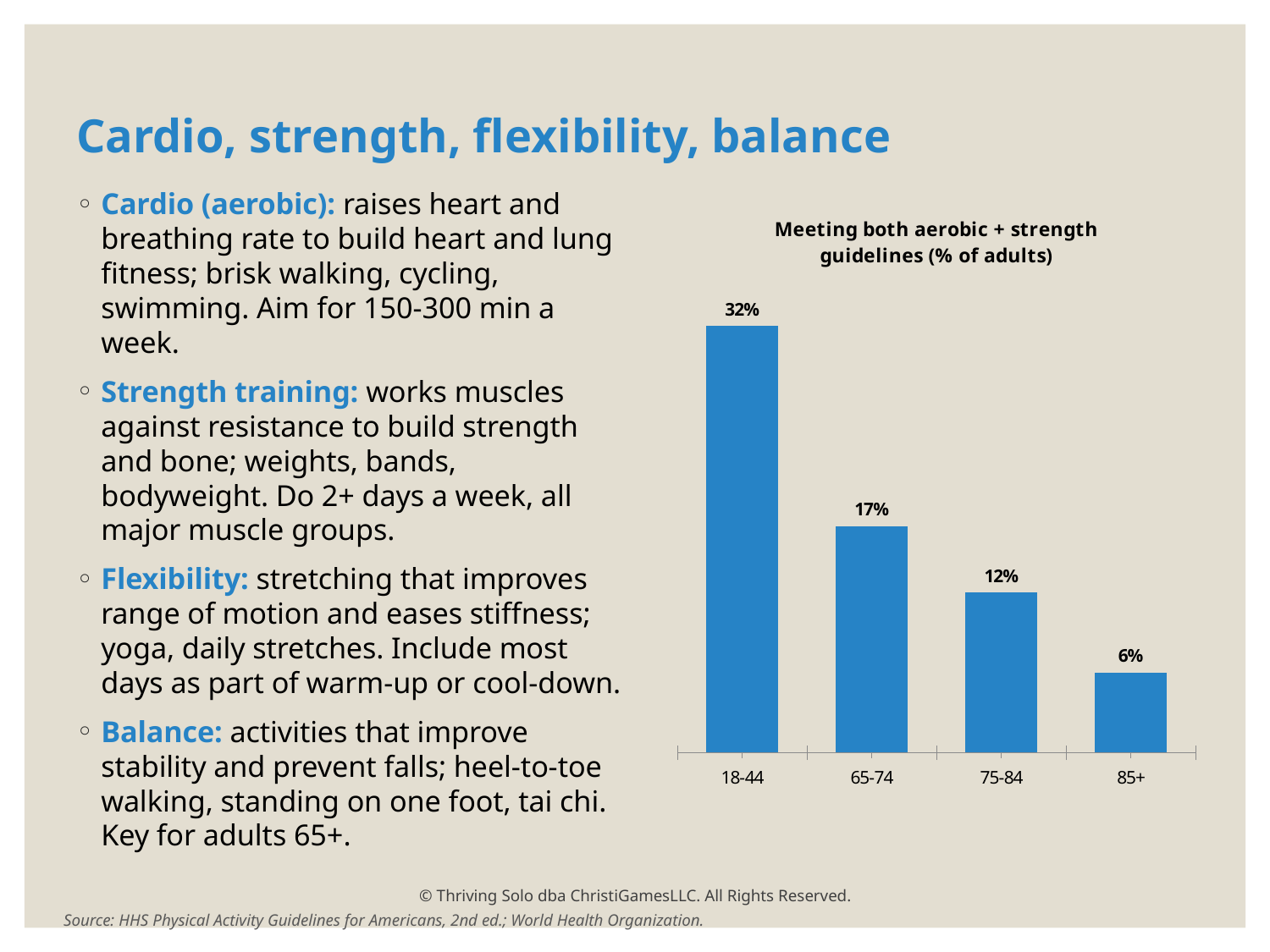
What is the value shown for the 85+ age group? 6% Which age group has the lowest percentage meeting both guidelines? 85+ Which age group has the highest percentage meeting both guidelines? 18-44 What percentage of adults aged 18-44 meet both aerobic and strength guidelines? 32% What is the difference in percentage points between the 75-84 and 85+ age groups? 6 What kind of chart is shown on the slide? Bar chart What is the value shown for the 65-74 age group? 17% Do the values rise or fall as age increases along the x axis? Fall Which age group has a larger value, 65-74 or 75-84? 65-74 What is the difference in percentage points between the 18-44 and 65-74 age groups? 15 How many age groups are shown in the chart? 4 What is the value shown for the 75-84 age group? 12%